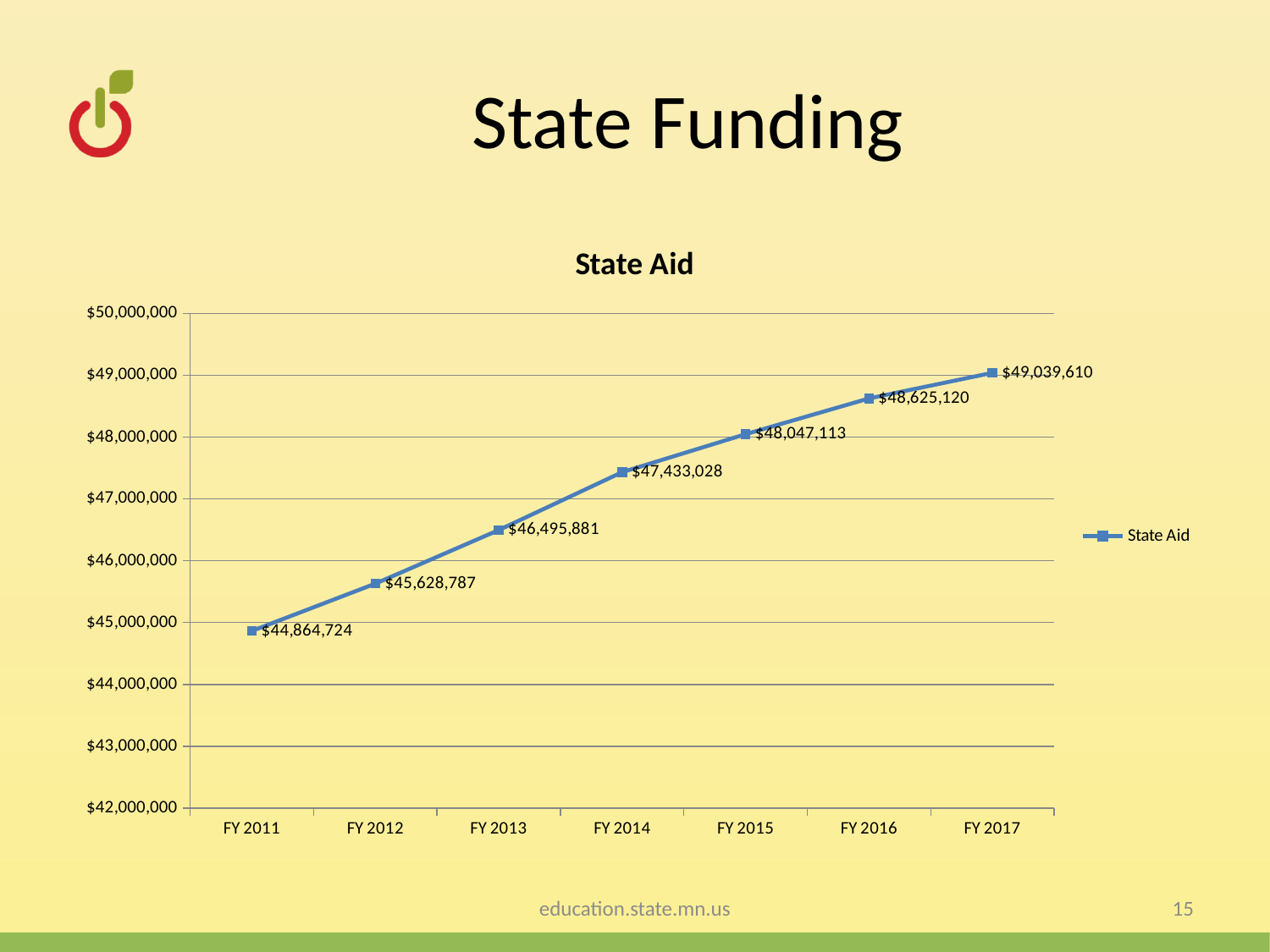
Do the State Aid values rise or fall from FY 2011 to FY 2017? rise What is the difference between the State Aid values for FY 2017 and FY 2011? $4,174,886 Is the State Aid value for FY 2015 greater or less than $48,000,000? greater What is the State Aid value for FY 2011? $44,864,724 What kind of chart is shown on the slide? line chart What is the difference between the State Aid values for FY 2012 and FY 2011? $764,063 What is the State Aid value for FY 2014? $47,433,028 How many fiscal years are plotted on the chart? 7 What is the State Aid value for FY 2016? $48,625,120 Which fiscal year has the highest State Aid value? FY 2017 Which is larger, the State Aid value for FY 2013 or for FY 2015? FY 2015 Which fiscal year has the lowest State Aid value? FY 2011